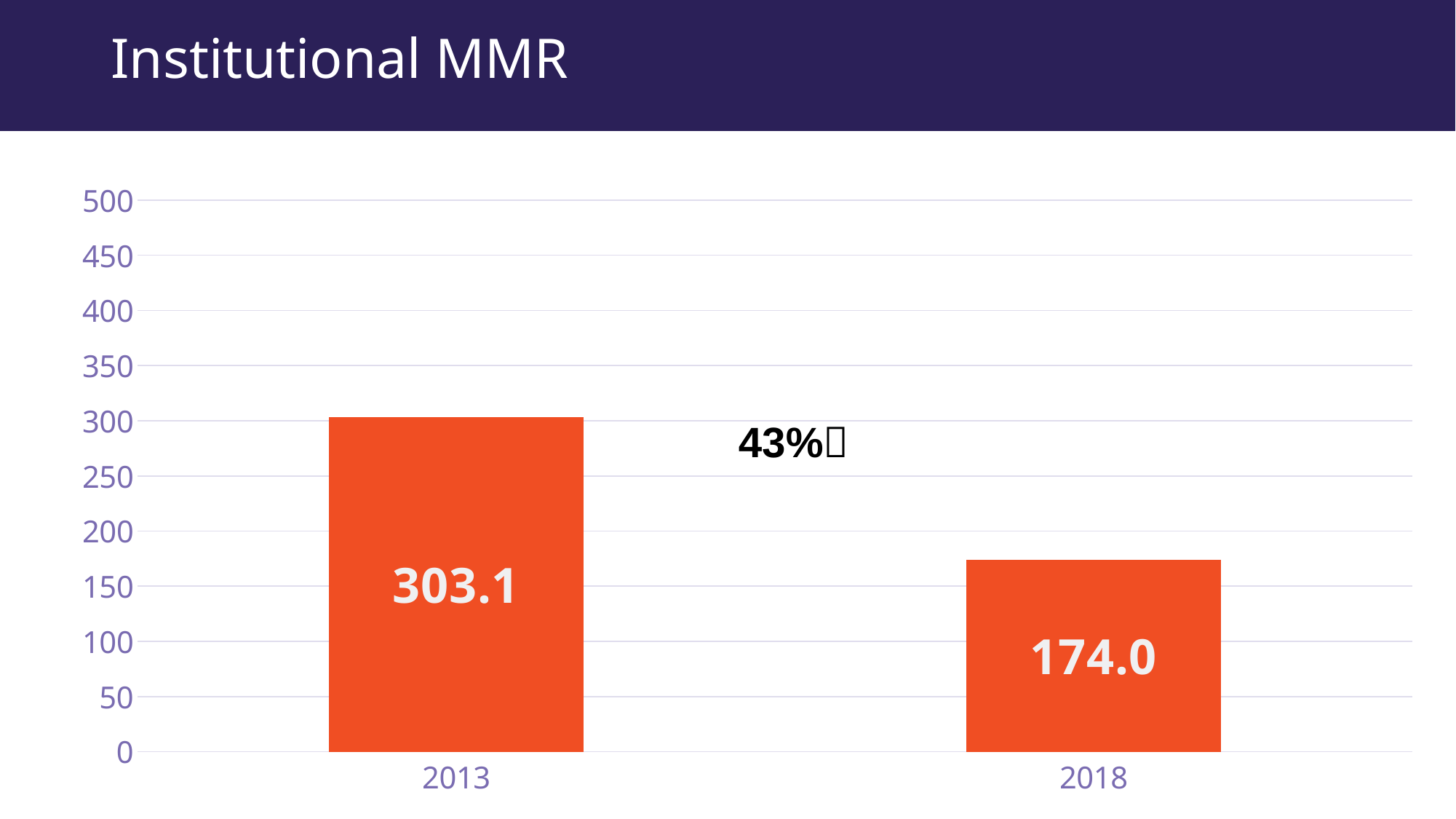
What is the title of the slide? Institutional MMR What is the difference between the 2013 and 2018 Institutional MMR values? 129.1 What percentage change is annotated between the two bars? 43% What is the Institutional MMR value for 2013? 303.1 Which year has the higher Institutional MMR? 2013 Is the Institutional MMR value for 2013 greater or less than 300? greater Which year has the lower Institutional MMR? 2018 What is the Institutional MMR value for 2018? 174.0 What kind of chart is shown on the slide? bar chart Does the Institutional MMR rise or fall from 2013 to 2018? fall How many years are shown on the chart? 2 Is the Institutional MMR value for 2018 greater or less than 200? less